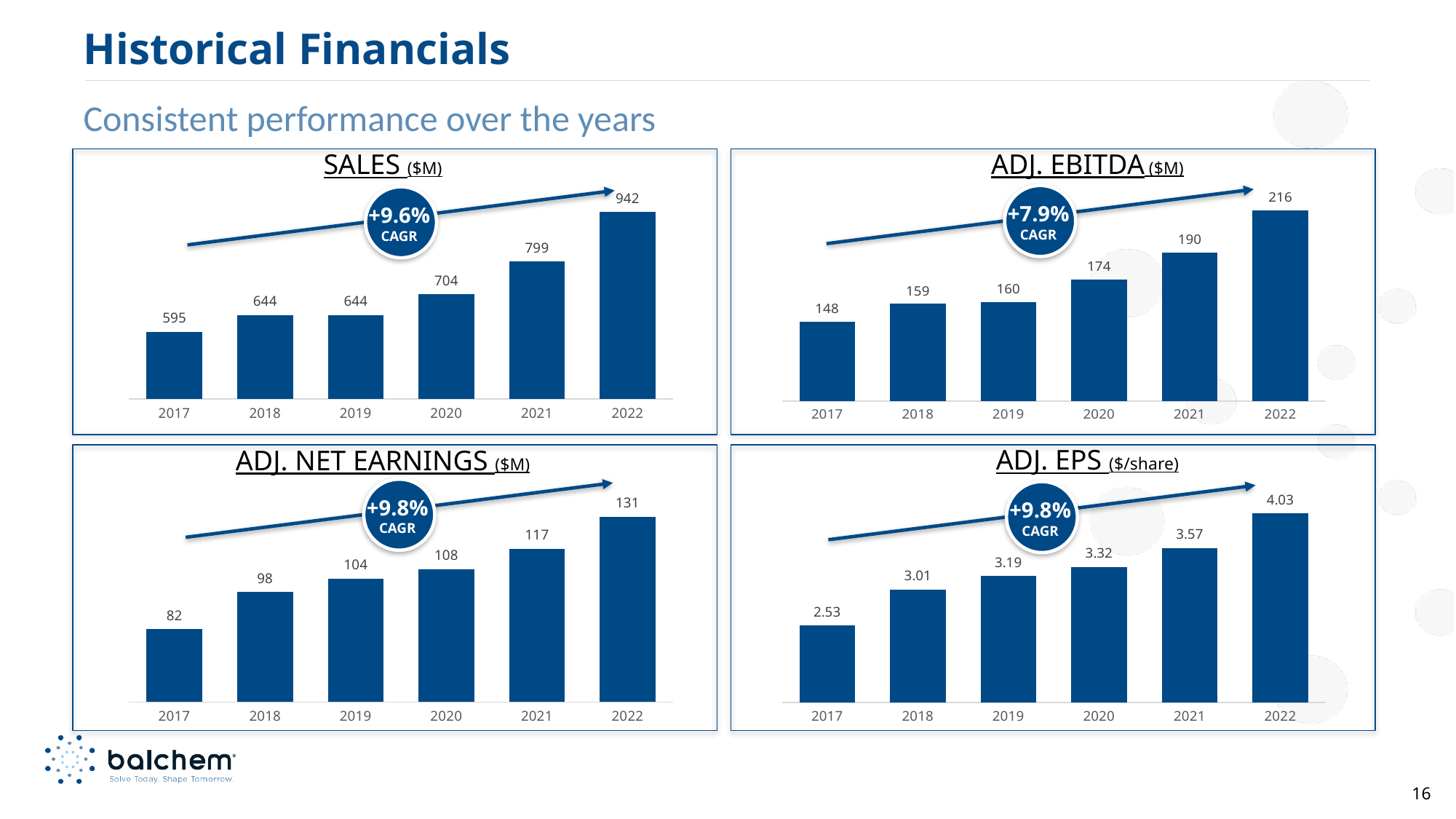
In the ADJ. NET EARNINGS ($M) chart, which is larger, the value for 2019 or the value for 2021? 2021 In the ADJ. EPS ($/share) chart, what is the value for 2021? 3.57 In the ADJ. EBITDA ($M) chart, what is the difference between the 2021 and 2020 values? 16 In the ADJ. EBITDA ($M) chart, which year has the highest value? 2022 In the ADJ. NET EARNINGS ($M) chart, which year has the lowest value? 2017 How many years are shown on the x axis of the ADJ. EPS ($/share) chart? 6 In the SALES ($M) chart, what is the difference between the 2022 and 2017 values? 347 In the SALES ($M) chart, what is the value for 2020? 704 In the SALES ($M) chart, what is the value for 2018? 644 What kind of chart is the SALES ($M) chart? bar chart In the ADJ. EPS ($/share) chart, do the values rise or fall from 2017 to 2022? rise What CAGR is shown on the ADJ. EBITDA ($M) chart? +7.9%